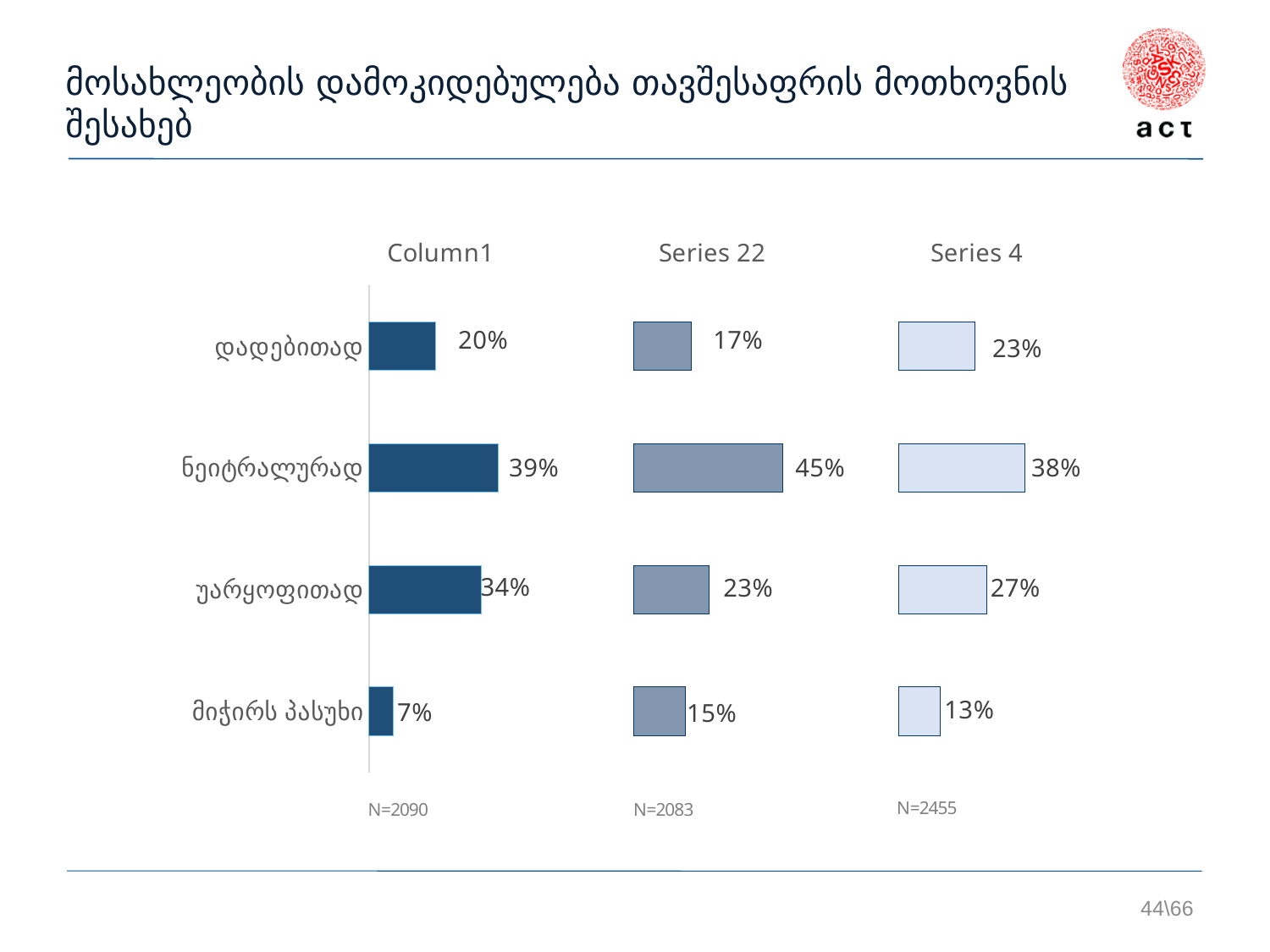
What is the difference between the ნეიტრალურად and უარყოფითად values in the Series 4 series? 11% How many categories are shown on the chart? 4 What is the value for მიჭირს პასუხი in the Series 22 series? 15% What is the value for ნეიტრალურად in the Column1 series? 39% What is the difference between the დადებითად values in Column1 and Series 22? 3% Which is larger: the უარყოფითად value in Column1 or the უარყოფითად value in Series 22? Column1 How many series does the chart show? 3 What is the value for დადებითად in the Series 4 series? 23% Which category has the lowest value in the Column1 series? მიჭირს პასუხი What is the sample size (N) shown under the Series 4 series? N=2455 What kind of chart is shown on the slide? bar chart Which category has the highest value in the Series 22 series? ნეიტრალურად